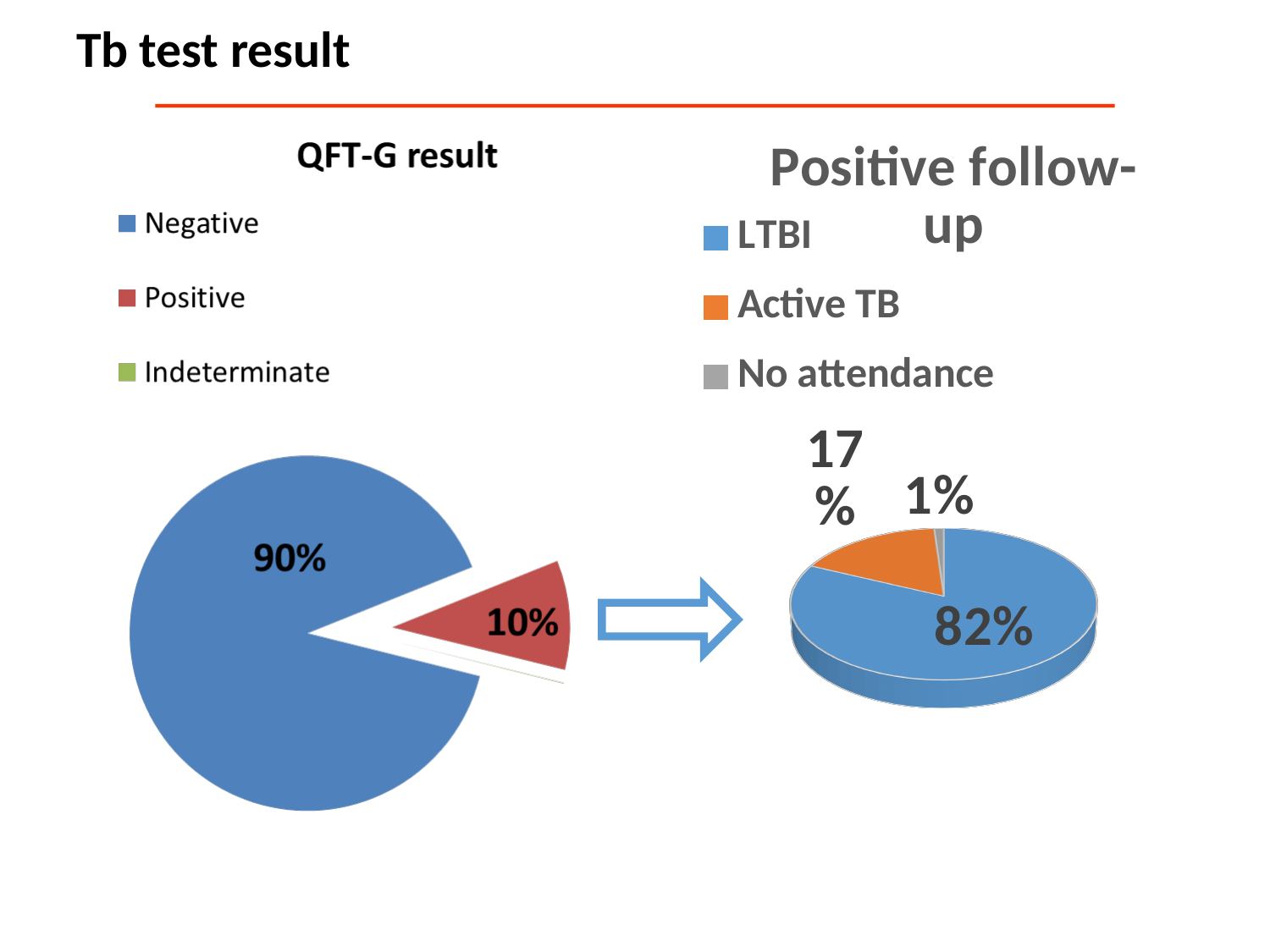
How many entries does the legend of the QFT-G result chart list? 3 In the QFT-G result chart, which category has the largest slice? Negative In the Positive follow-up chart, which colour represents Active TB? Orange What kind of chart is the QFT-G result chart? Pie chart In the Positive follow-up chart, which category has the smallest slice? No attendance In the Positive follow-up chart, what share is Active TB? 17% In the Positive follow-up chart, what share is No attendance? 1% In the QFT-G result chart, what share of results is Positive? 10% In the QFT-G result chart, what share of results is Negative? 90% In the Positive follow-up chart, what is the difference between the LTBI and Active TB shares? 65% In the Positive follow-up chart, what share is LTBI? 82% In the QFT-G result chart, what is the difference between the Negative and Positive shares? 80%